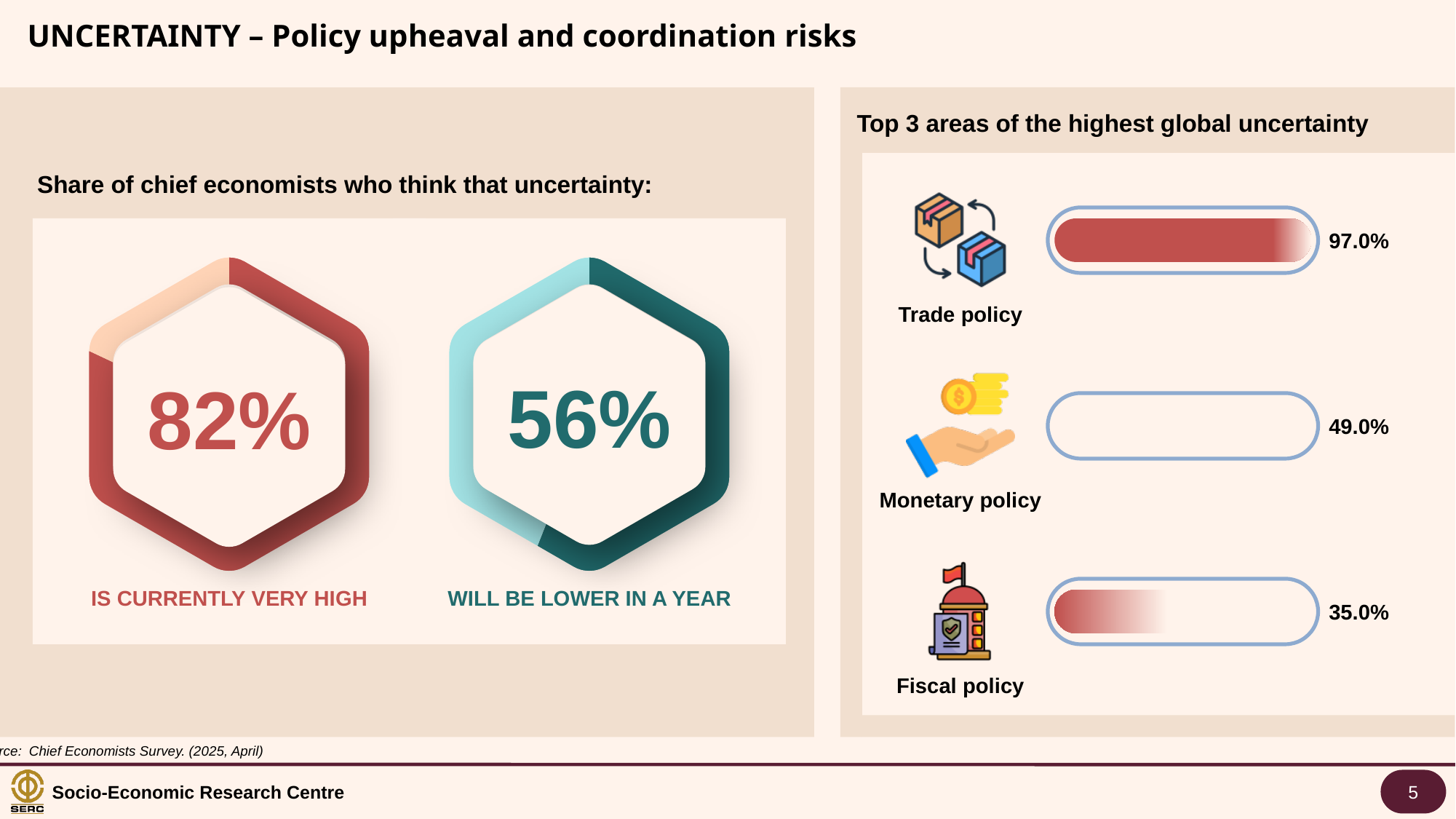
In the 'Top 3 areas of the highest global uncertainty' chart, what is the value for Fiscal policy? 35.0% In the 'Top 3 areas of the highest global uncertainty' chart, what is the value for Monetary policy? 49.0% In the 'Top 3 areas of the highest global uncertainty' chart, which area has the highest value? Trade policy In the 'Top 3 areas of the highest global uncertainty' chart, which area has the lowest value? Fiscal policy In the 'Top 3 areas of the highest global uncertainty' chart, what is the value for Trade policy? 97.0% In the 'Top 3 areas of the highest global uncertainty' chart, which is larger: the value for Monetary policy or Fiscal policy? Monetary policy How many areas are shown in the 'Top 3 areas of the highest global uncertainty' chart? 3 What kind of chart is the 'Top 3 areas of the highest global uncertainty' chart? Bar chart In the 'Top 3 areas of the highest global uncertainty' chart, what is the difference between the values for Trade policy and Monetary policy? 48.0% In the left chart on the share of chief economists, what share think that uncertainty is currently very high? 82% In the left chart on the share of chief economists, what share think that uncertainty will be lower in a year? 56% In the 'Top 3 areas of the highest global uncertainty' chart, what is the difference between the values for Monetary policy and Fiscal policy? 14.0%